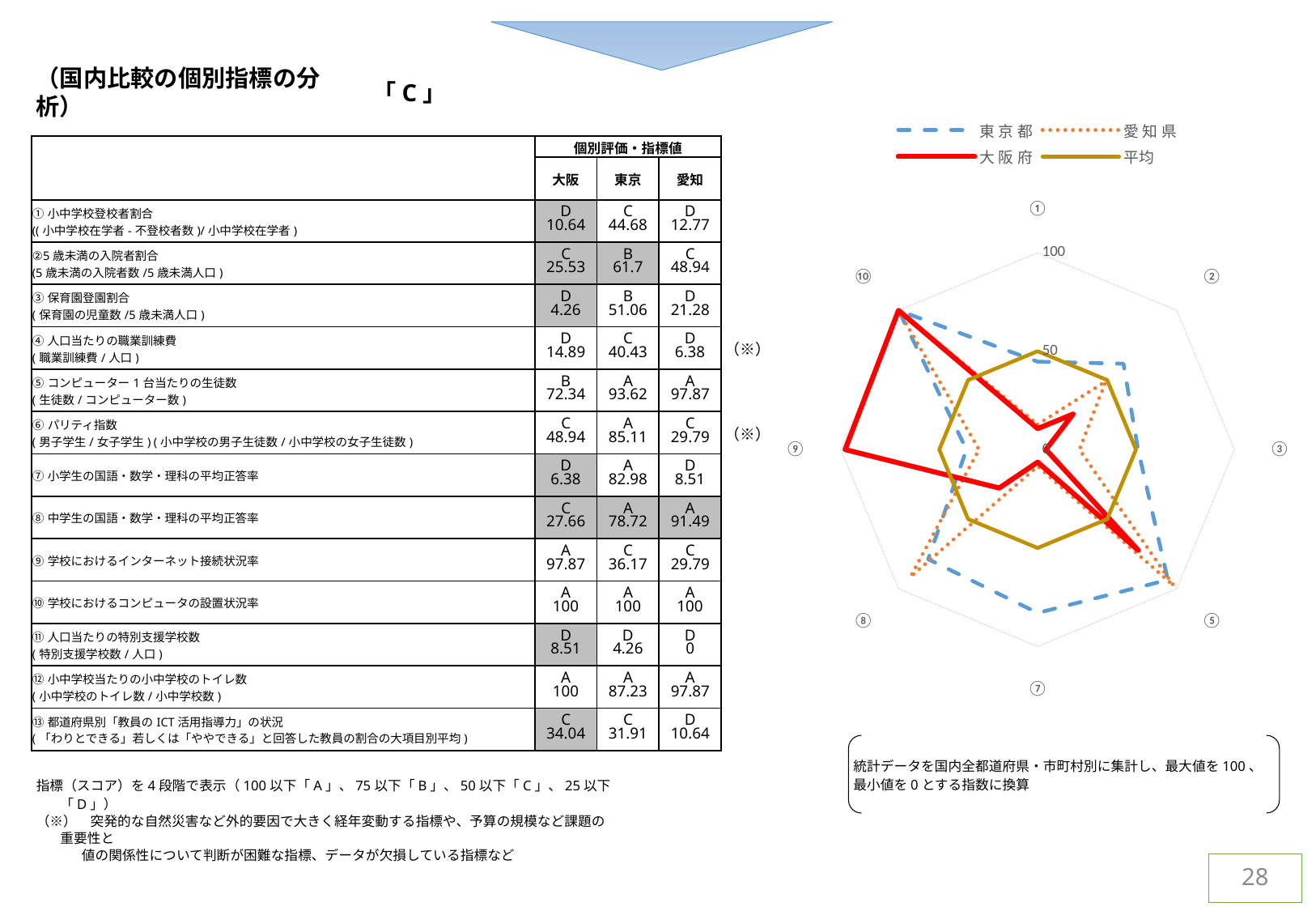
In the radar chart, is the value for 東京都 on axis ⑤ greater or less than 50? greater What kind of chart is shown on the right side of the slide? radar chart Which series in the radar chart is drawn as a solid red line? 大阪府 In the radar chart, which series has the larger value on axis ⑨, 大阪府 or 東京都? 大阪府 In the radar chart, is the value for 愛知県 on axis ⑤ greater or less than 50? greater In the radar chart, is the value for 大阪府 on axis ③ greater or less than 50? less Which series in the radar chart is drawn as a blue dashed line? 東京都 In the radar chart, which series has the larger value on axis ③, 東京都 or 大阪府? 東京都 How many series does the legend of the radar chart list? 4 How many numbered axes (categories) does the radar chart have? 8